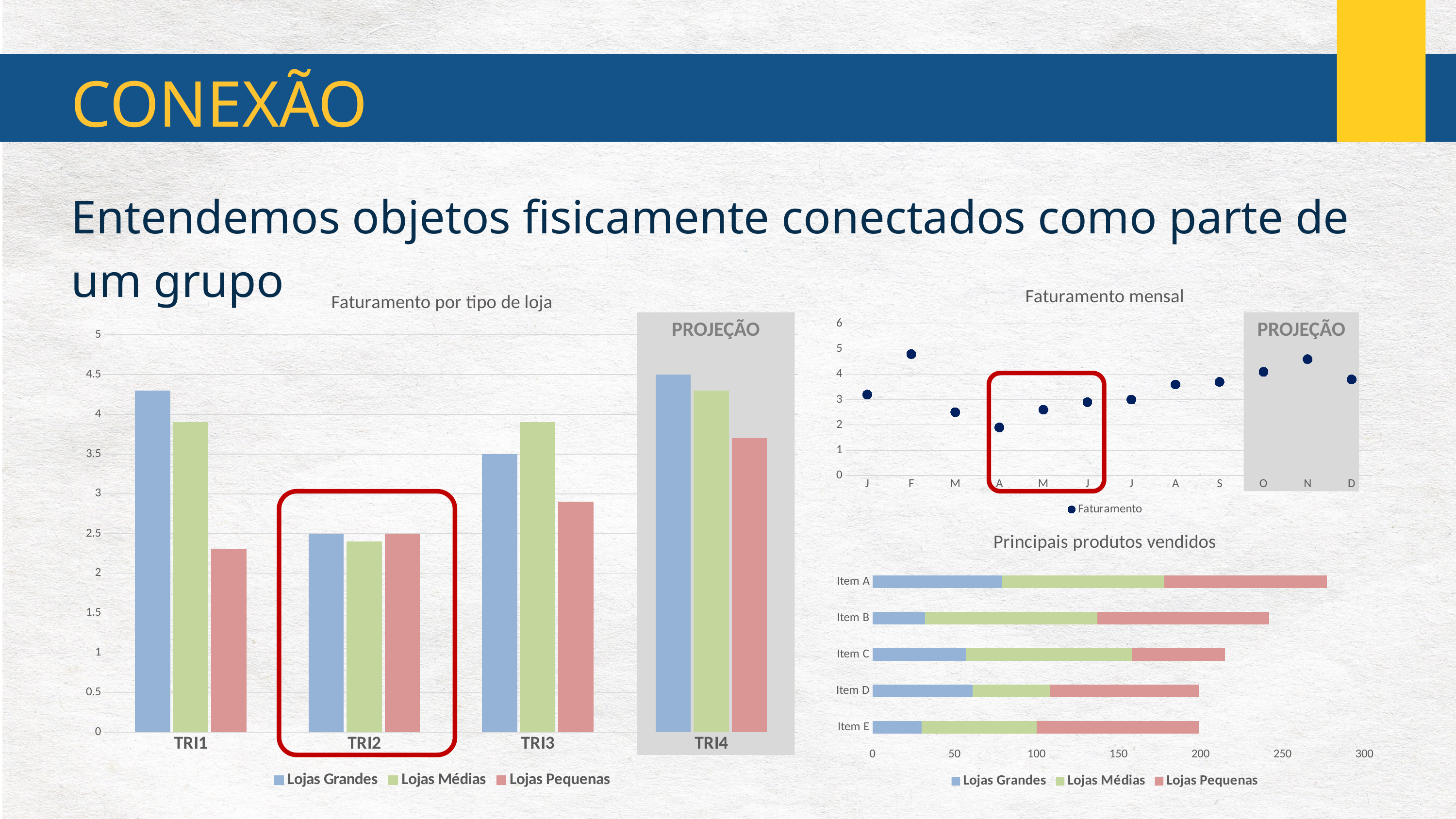
In "Faturamento por tipo de loja", which quarter is marked as PROJEÇÃO? TRI4 In "Faturamento por tipo de loja", is the value for Lojas Grandes in TRI1 greater or less than 4? greater In "Faturamento por tipo de loja", is the value for Lojas Grandes in TRI3 greater or less than 3? greater In "Principais produtos vendidos", is the total for Item A greater or less than 250? greater What type of chart is "Faturamento por tipo de loja"? bar chart In "Faturamento por tipo de loja", which quarter has the highest value for Lojas Pequenas? TRI4 How many categories are shown on the x axis of "Faturamento por tipo de loja"? 4 In "Faturamento mensal", which month has the lowest value? A (April) How many series does the legend of "Faturamento por tipo de loja" list? 3 In "Principais produtos vendidos", which item has the longest total bar? Item A How many data points are plotted in "Faturamento mensal"? 12